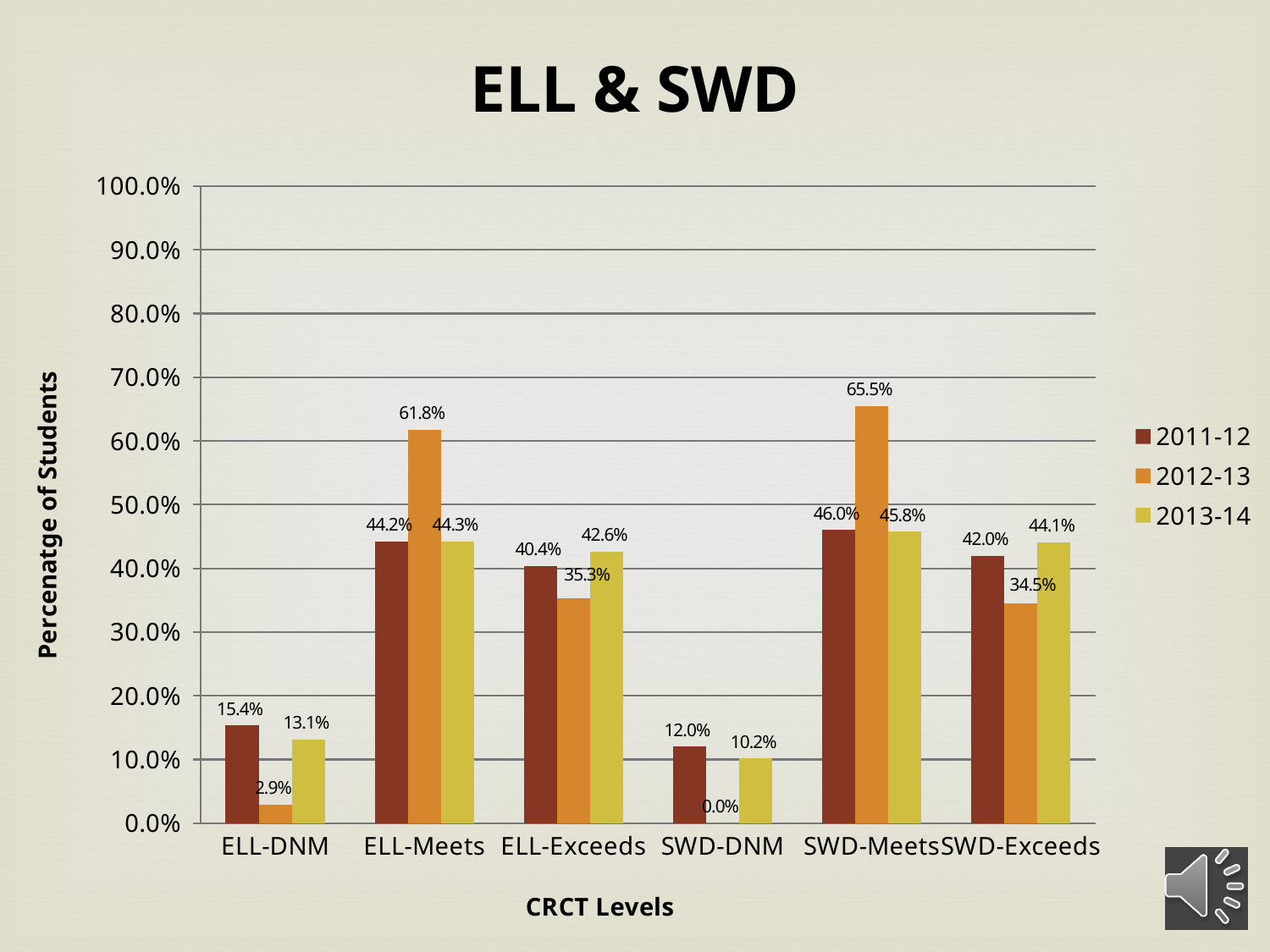
How many series does the legend list? 3 What is the value for 2013-14 in the SWD-DNM category? 10.2% Which is larger in the ELL-Exceeds category: the 2011-12 value or the 2012-13 value? 2011-12 Which category has the lowest value for the 2012-13 series? SWD-DNM What kind of chart is shown on the slide? bar chart What is the difference between the 2012-13 and 2011-12 values in the SWD-Meets category? 19.5% What is the value for 2012-13 in the ELL-Meets category? 61.8% How many categories are shown on the x axis? 6 Which category has the highest value for the 2012-13 series? SWD-Meets What is the value for 2011-12 in the SWD-Exceeds category? 42.0% Is the value for 2012-13 in the ELL-Meets category greater or less than 60.0%? greater What is the title of the chart? ELL & SWD